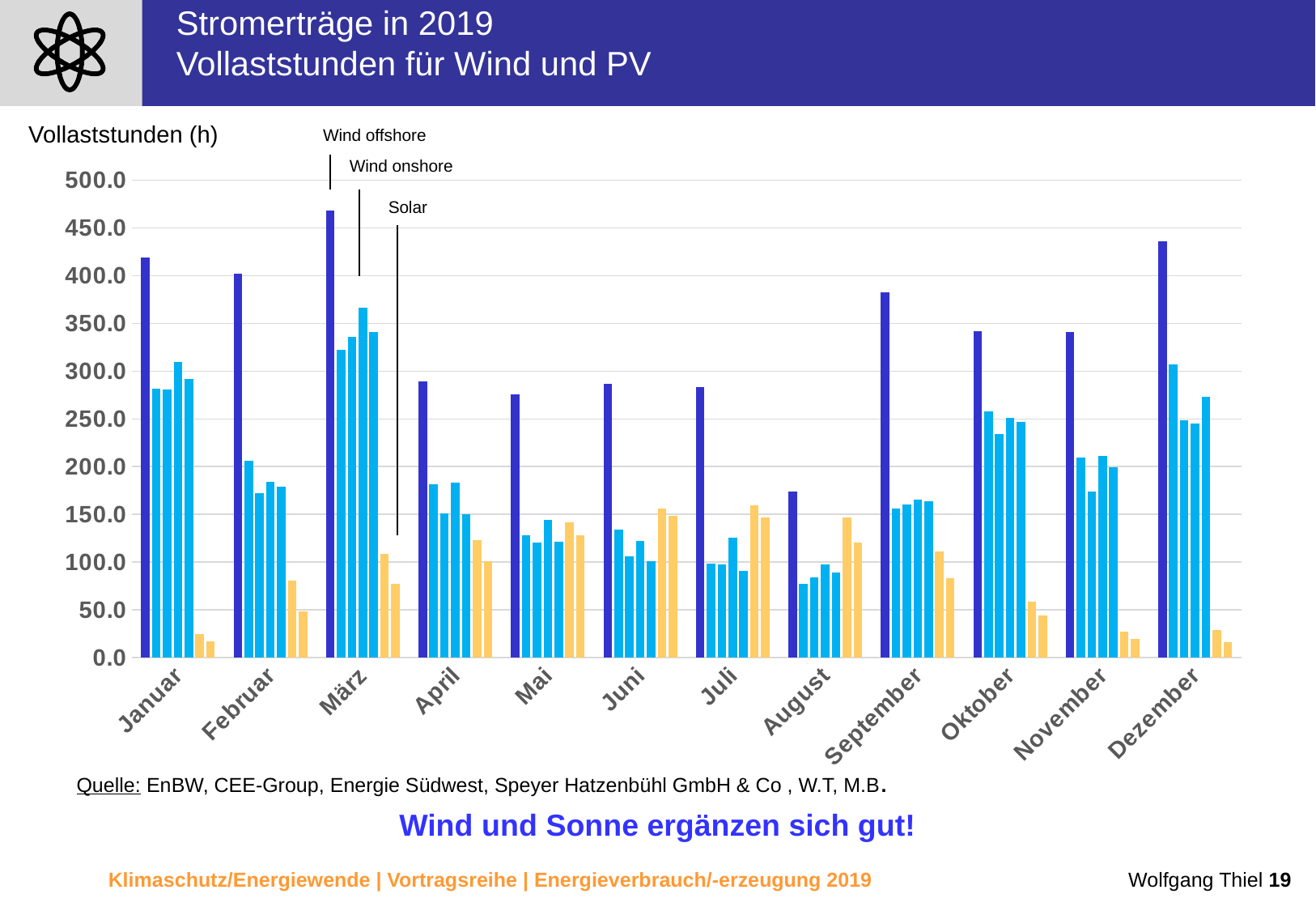
How many series does the chart's legend list? 3 How many months are shown along the x axis of the chart? 12 What is the label of the y axis of the chart? Vollaststunden (h) Which month has the larger Wind offshore value, November or Dezember? Dezember Which month has the larger Wind offshore value, Januar or April? Januar In which month is the Wind offshore value lowest? August What kind of chart is shown on the slide? bar chart Is the Wind offshore value for März greater or less than 450? greater Is the Wind offshore value for August greater or less than 200? less Is the Wind offshore value for Dezember greater or less than 400? greater In which month is the Wind offshore value highest? März